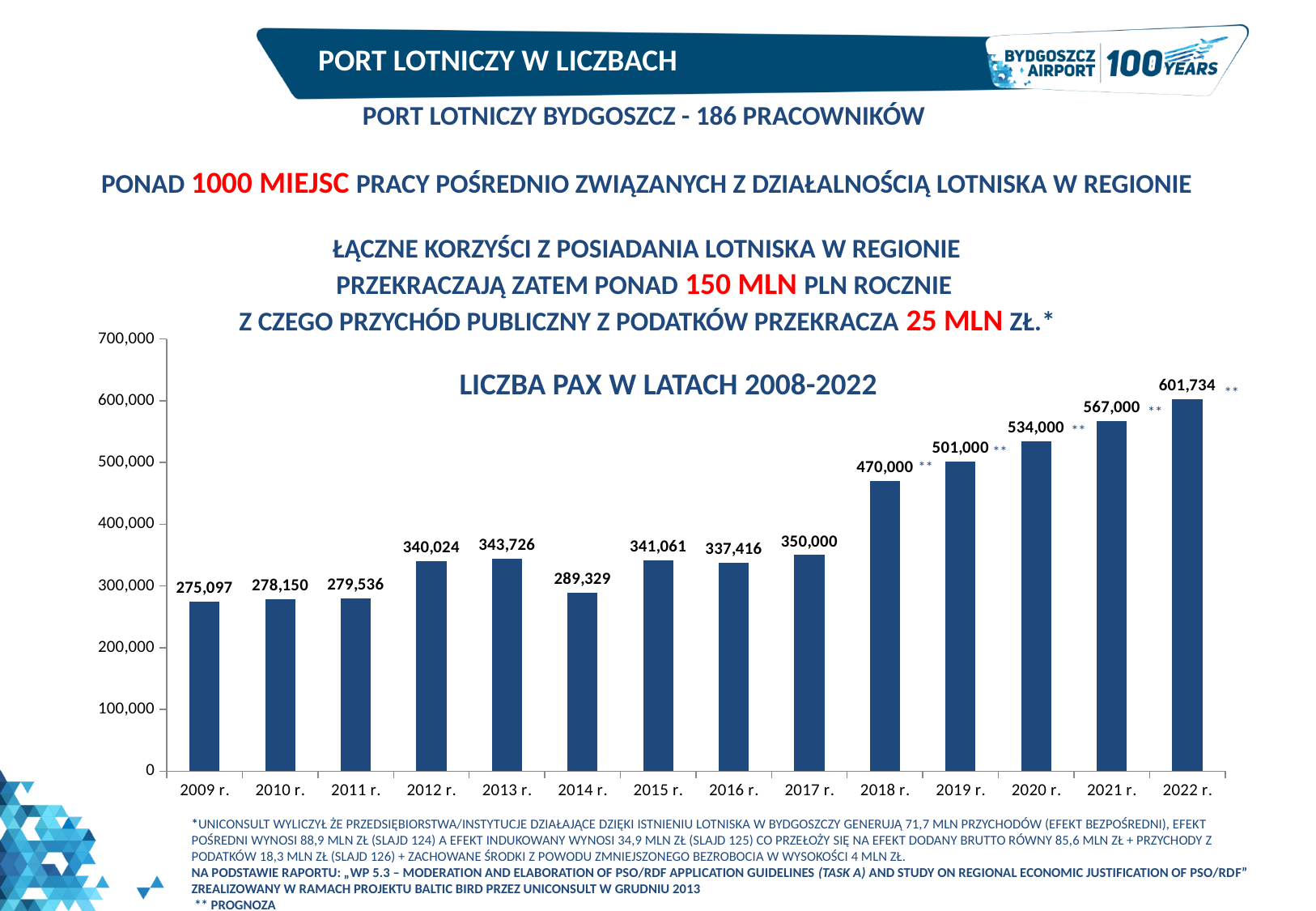
Which is larger, the value for 2014 r. or the value for 2015 r.? 2015 r. What is the value for 2014 r. in the chart? 289,329 How many years are shown in the chart? 14 What is the value for 2018 r. in the chart? 470,000 What is the title of the chart? LICZBA PAX W LATACH 2008-2022 What kind of chart is shown on the slide? bar chart Which year has the highest value in the chart? 2022 r. What is the difference between the values for 2013 r. and 2012 r.? 3,702 Which year has the lowest value in the chart? 2009 r. Is the value for 2019 r. greater or less than 400,000? greater What is the value for 2012 r. in the chart? 340,024 What is the difference between the values for 2022 r. and 2021 r.? 34,734